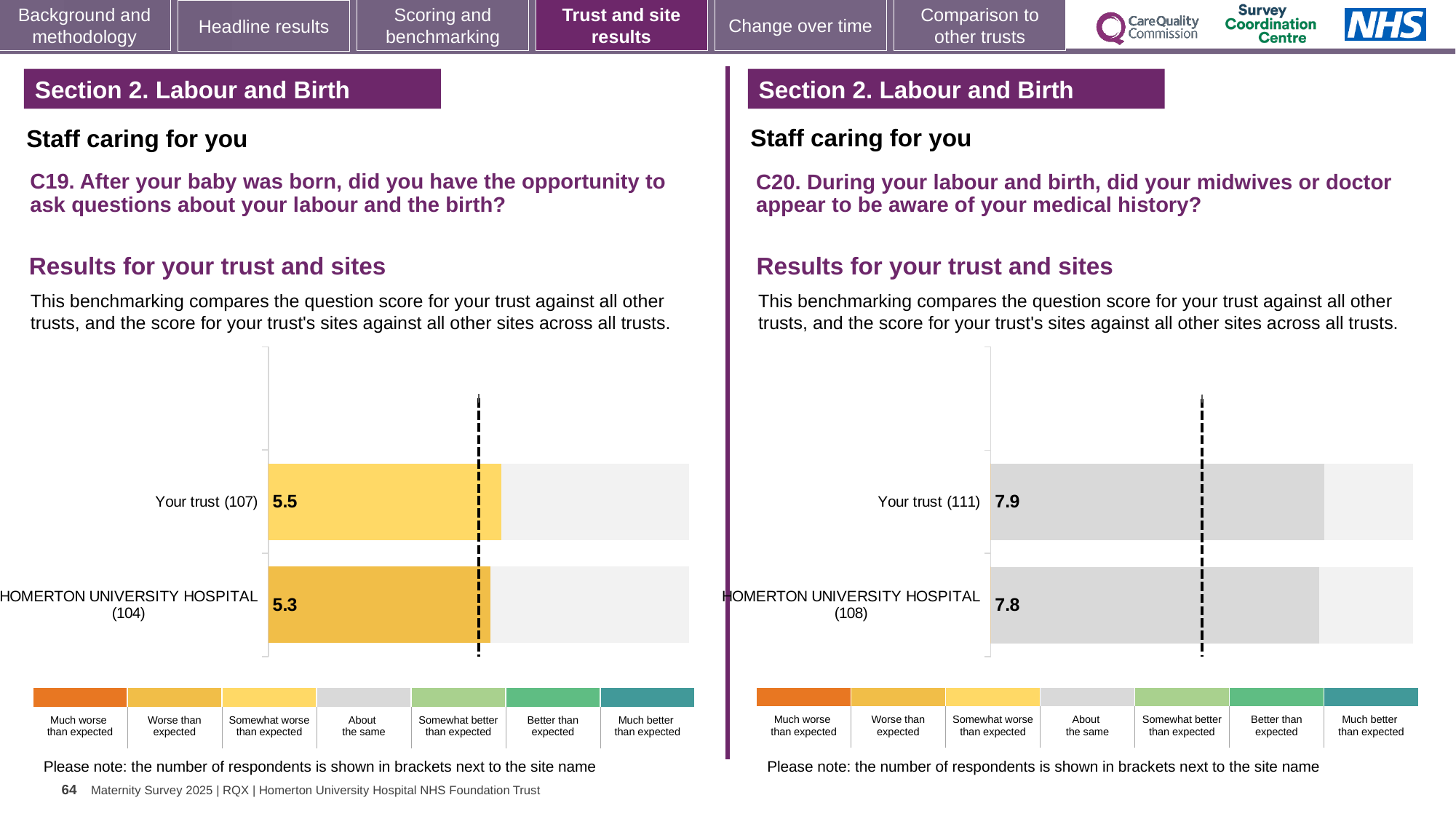
In the C20 chart on the right, which has the lower score, Your trust or Homerton University Hospital? Homerton University Hospital In the C19 chart on the left, how many respondents are shown in brackets for Your trust? 107 What type of chart is used in the C20 chart on the right? Bar chart In the C20 chart on the right, how many respondents are shown in brackets for Homerton University Hospital? 108 In the C19 chart on the left, what is the score for Your trust? 5.5 In the C20 chart on the right, what is the difference between the Your trust score and the Homerton University Hospital score? 0.1 In the C20 chart on the right, what is the score for Homerton University Hospital? 7.8 In the C20 chart on the right, what is the score for Your trust? 7.9 In the C19 chart on the left, which has the higher score, Your trust or Homerton University Hospital? Your trust In the C19 chart on the left, what is the difference between the Your trust score and the Homerton University Hospital score? 0.2 How many bars are plotted in the C19 chart on the left? 2 In the C19 chart on the left, what is the score for Homerton University Hospital? 5.3